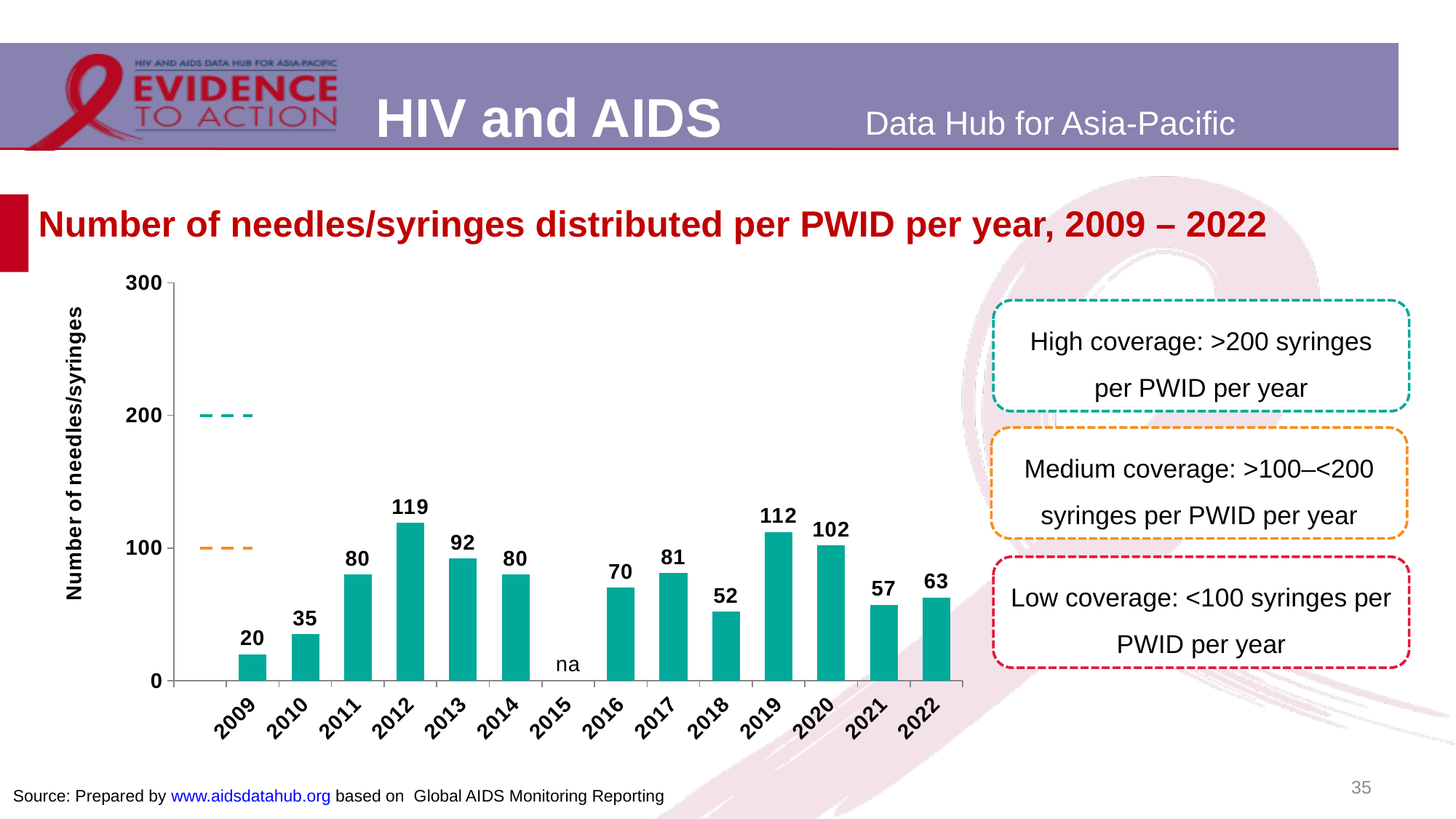
How many years are shown on the x axis? 14 What is the label of the y axis? Number of needles/syringes Which year has the highest number of needles/syringes distributed per PWID? 2012 What label is shown in place of a bar for 2015? na Which is larger, the value for 2020 or the value for 2021? 2020 What is the value shown for 2019? 112 What is the difference between the values for 2012 and 2013? 27 What is the number of needles/syringes distributed per PWID per year in 2012? 119 What kind of chart is shown on the slide? bar chart Which year has the lowest plotted value? 2009 What is the value shown for 2009? 20 Is the value for 2019 greater or less than 100? greater